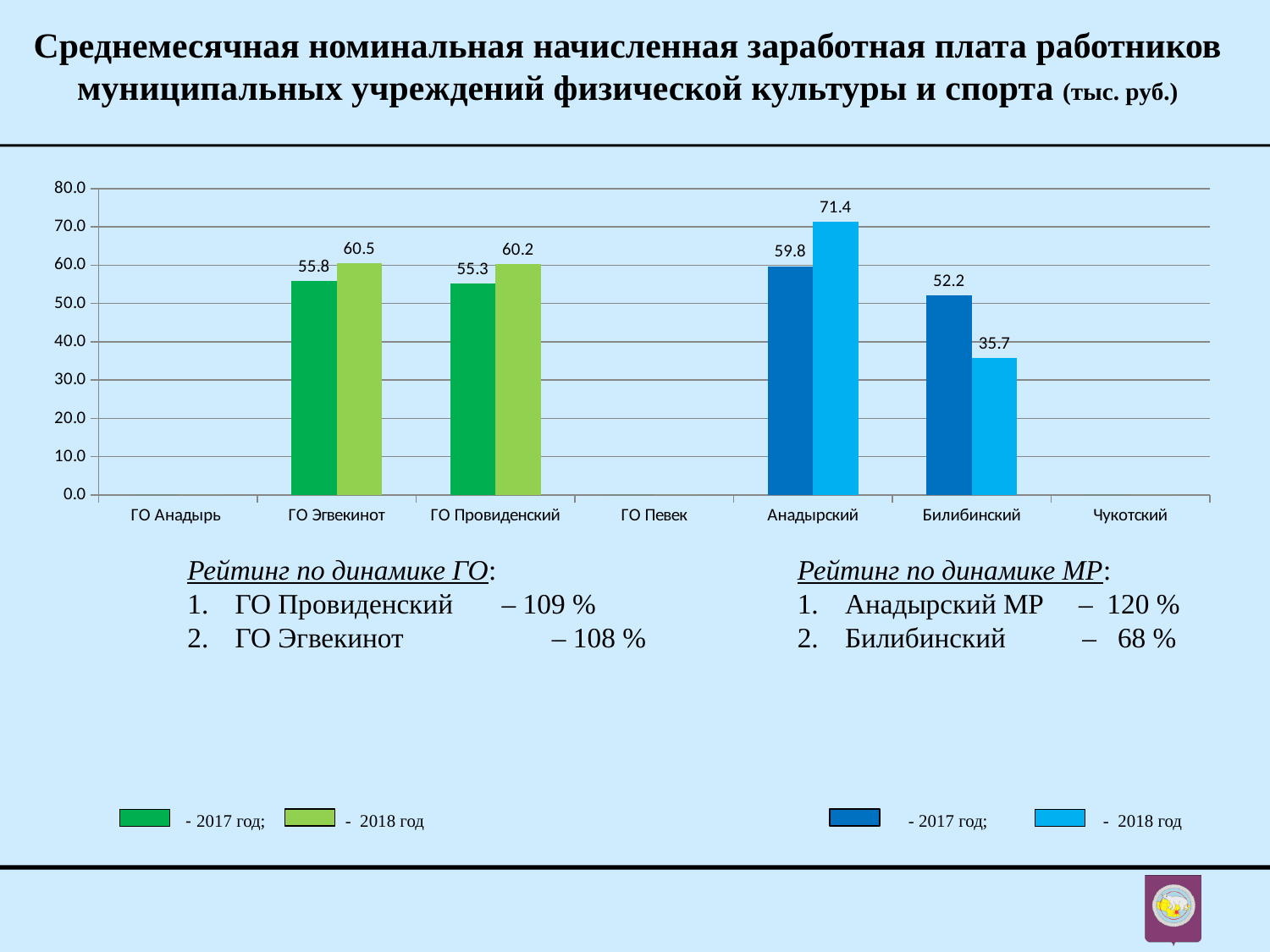
What is the difference between the 2018 and 2017 values for Анадырский? 11.6 How many categories are shown on the x axis? 7 What is the 2018 value for Билибинский? 35.7 What is the difference between the 2017 and 2018 values for Билибинский? 16.5 Which category has the lowest 2018 value among those with bars? Билибинский What is the 2018 value for Анадырский? 71.4 What is the 2017 value for ГО Эгвекинот? 55.8 What is the 2017 value for ГО Провиденский? 55.3 Which category has the highest 2018 value? Анадырский Which is larger: the 2018 value for ГО Эгвекинот or the 2018 value for ГО Провиденский? ГО Эгвекинот What kind of chart is shown on the slide? bar chart Did the value for Билибинский rise or fall from 2017 to 2018? fall